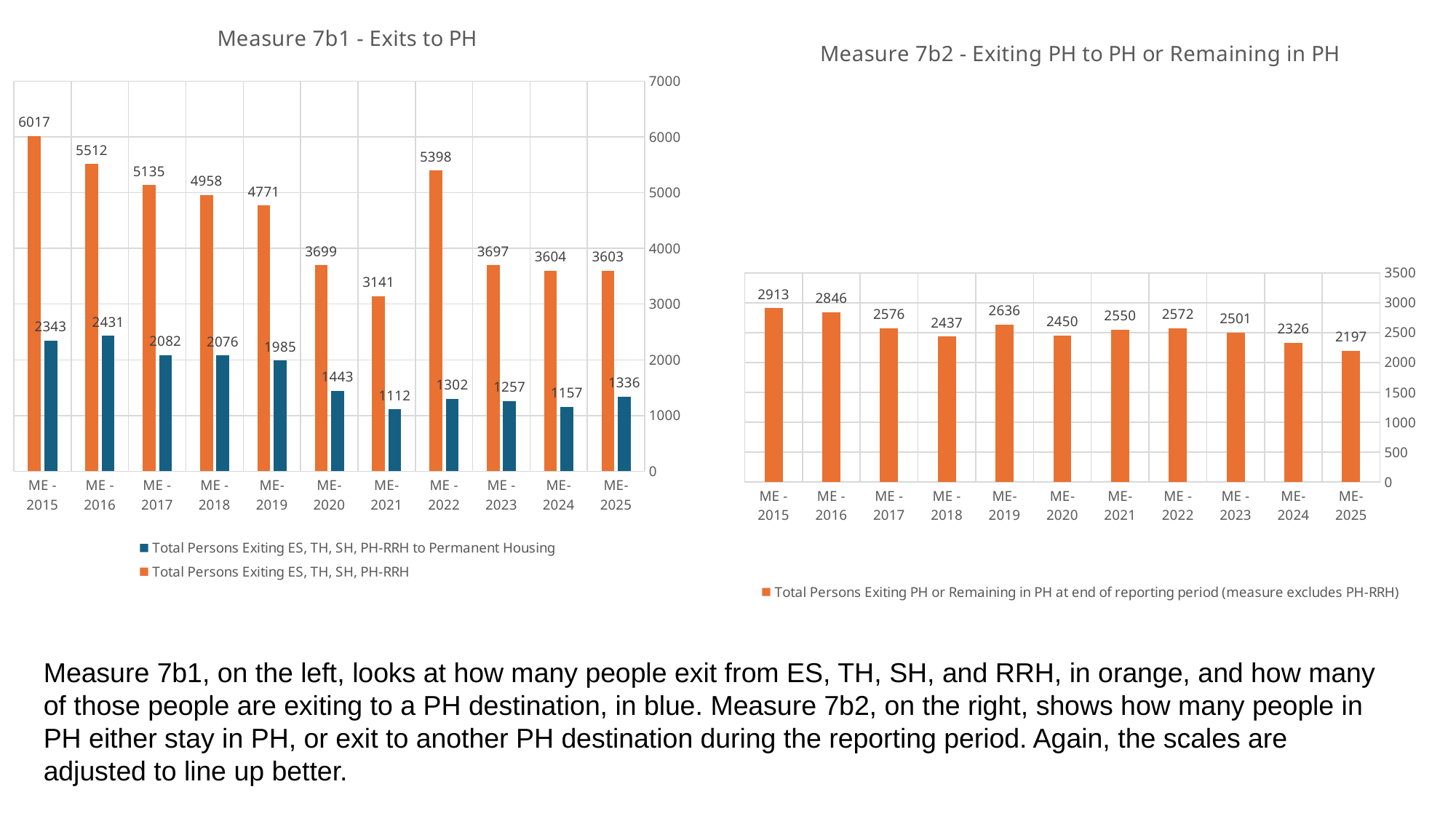
In the 'Measure 7b1 - Exits to PH' chart, what is the value of Total Persons Exiting ES, TH, SH, PH-RRH to Permanent Housing for ME - 2022? 1302 In the 'Measure 7b1 - Exits to PH' chart, how many series does the legend list? 2 In the 'Measure 7b2 - Exiting PH to PH or Remaining in PH' chart, what is the difference between the values for ME - 2015 and ME - 2025? 716 In the 'Measure 7b1 - Exits to PH' chart, what is the difference between Total Persons Exiting ES, TH, SH, PH-RRH and Total Persons Exiting ES, TH, SH, PH-RRH to Permanent Housing for ME - 2020? 2256 In the 'Measure 7b1 - Exits to PH' chart, what is the value of Total Persons Exiting ES, TH, SH, PH-RRH for ME - 2015? 6017 In the 'Measure 7b1 - Exits to PH' chart, is the value of Total Persons Exiting ES, TH, SH, PH-RRH for ME - 2016 greater or less than 5000? greater In the 'Measure 7b2 - Exiting PH to PH or Remaining in PH' chart, what is the value for ME - 2019? 2636 In the 'Measure 7b2 - Exiting PH to PH or Remaining in PH' chart, which year has the highest value? ME - 2015 In the 'Measure 7b2 - Exiting PH to PH or Remaining in PH' chart, how many years are shown on the x axis? 11 What kind of chart is the 'Measure 7b2 - Exiting PH to PH or Remaining in PH' chart? Bar chart In the 'Measure 7b1 - Exits to PH' chart, which year has the lowest value for Total Persons Exiting ES, TH, SH, PH-RRH to Permanent Housing? ME - 2021 In the 'Measure 7b2 - Exiting PH to PH or Remaining in PH' chart, which year has the lowest value? ME - 2025